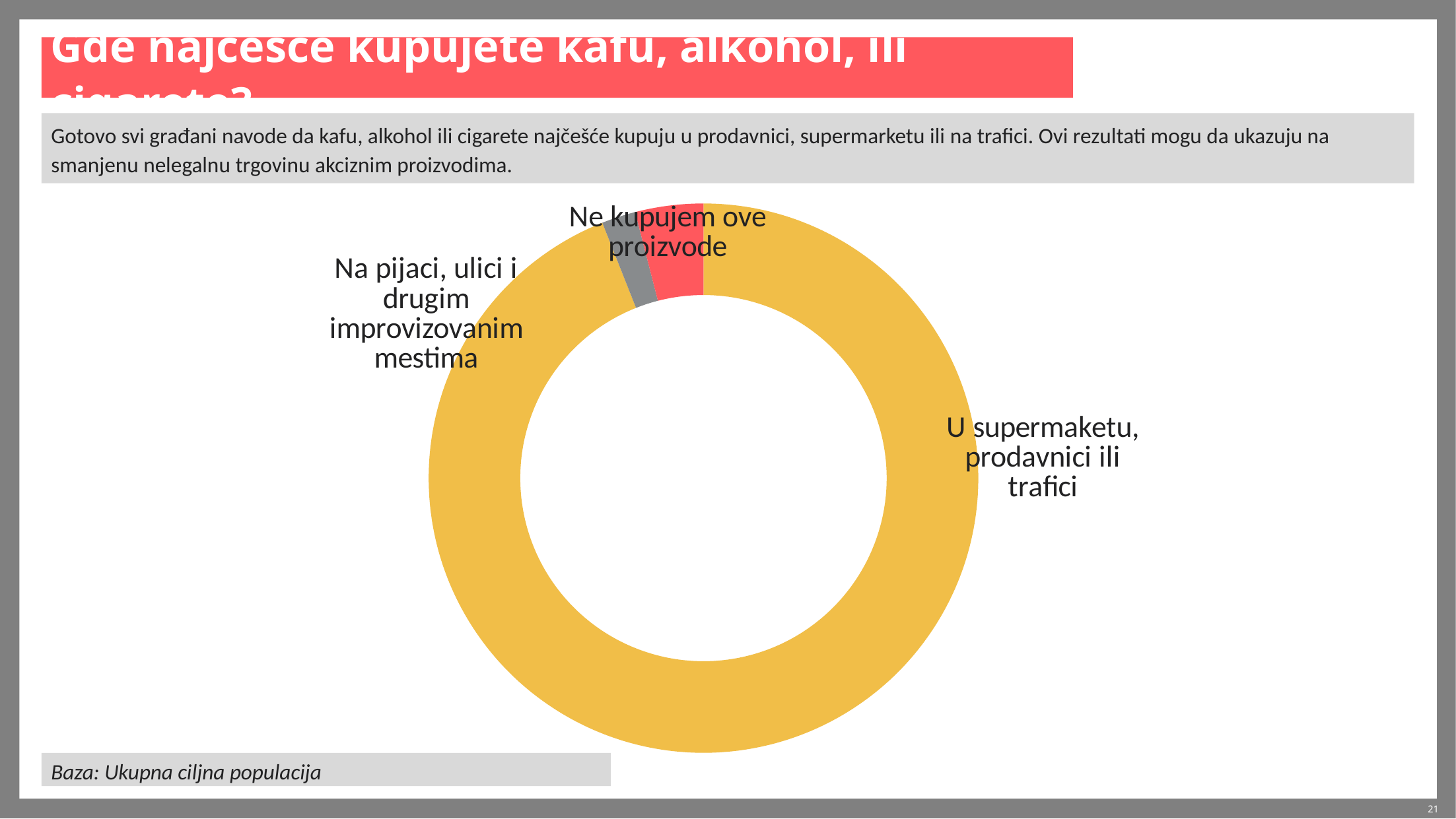
How many categories (slices) does the chart show? 3 Which category has the largest share of the chart? U supermaketu, prodavnici ili trafici What colour is the slice for "U supermaketu, prodavnici ili trafici"? yellow Which is larger: the slice for "U supermaketu, prodavnici ili trafici" or the slice for "Ne kupujem ove proizvode"? U supermaketu, prodavnici ili trafici What kind of chart is shown on the slide? doughnut chart What colour is the slice for "Ne kupujem ove proizvode"? red Which is larger: the slice for "Na pijaci, ulici i drugim improvizovanim mestima" or the slice for "U supermaketu, prodavnici ili trafici"? U supermaketu, prodavnici ili trafici